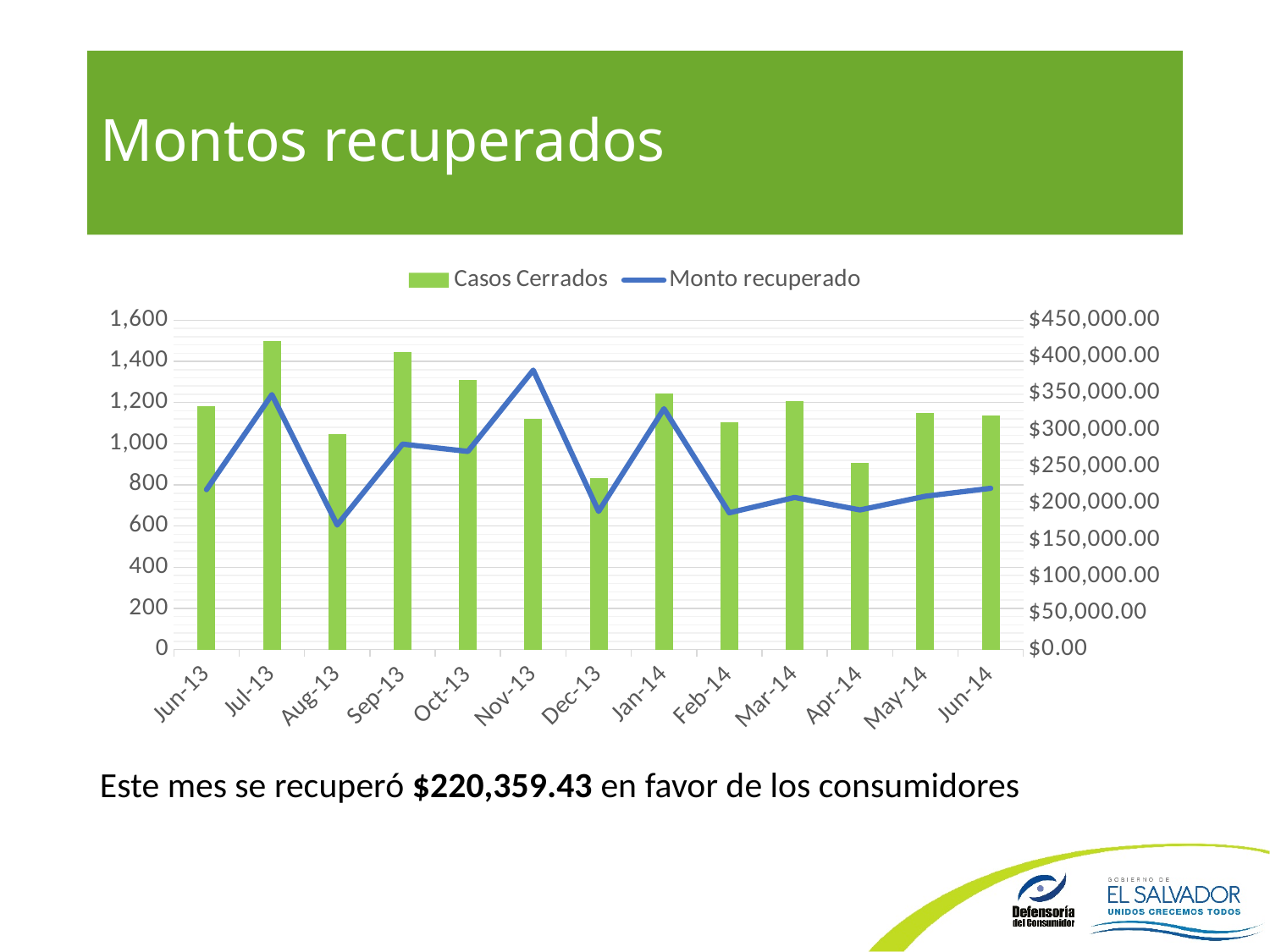
Which month has more Casos Cerrados, Sep-13 or Oct-13? Sep-13 Which month has the highest number of Casos Cerrados? Jul-13 Is the Casos Cerrados value for Dec-13 greater or less than 1,000? less How many series does the legend list? 2 Which month has the lowest number of Casos Cerrados? Dec-13 What is the title of the slide containing the chart? Montos recuperados Is the Monto recuperado for Nov-13 greater or less than $350,000.00? greater According to the text below the chart, how much was recovered this month in favor of consumers? $220,359.43 Is the Casos Cerrados value for Jul-13 greater or less than 1,400? greater Which month has the highest Monto recuperado? Nov-13 What kind of chart is shown on the slide? A combination bar and line chart How many months are shown on the x axis? 13